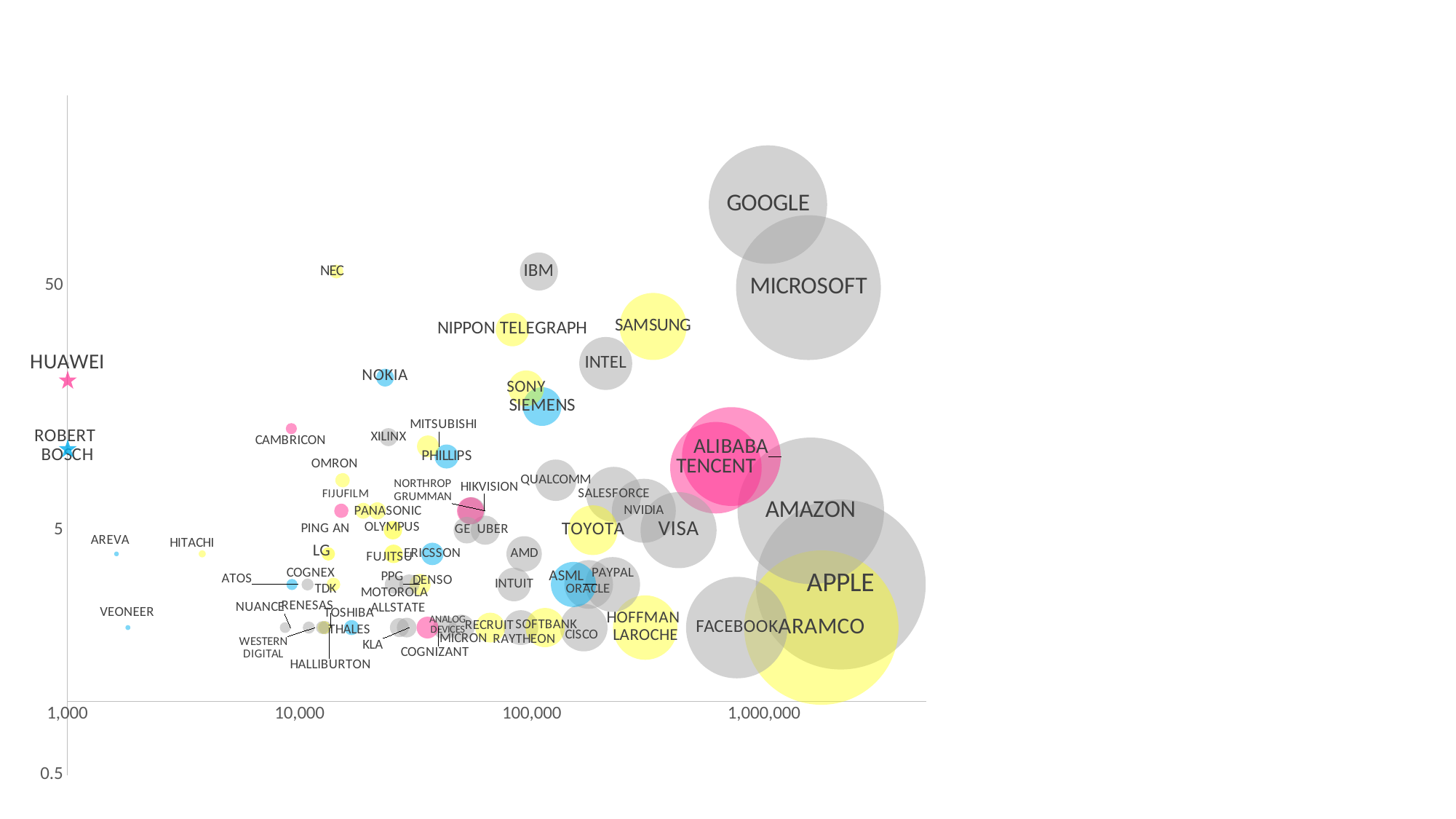
Is the vertical-axis value for SAMSUNG greater or less than 50? less Which two companies are marked with star symbols instead of bubbles? HUAWEI and ROBERT BOSCH Which is positioned higher on the vertical axis, GOOGLE or MICROSOFT? GOOGLE Is the horizontal-axis value for AREVA greater or less than 10,000? less Is the horizontal-axis value for SAMSUNG greater or less than 100,000? greater Which is positioned higher on the vertical axis, AMAZON or APPLE? AMAZON Which company's bubble is positioned highest on the vertical axis? GOOGLE What kind of chart is shown on the slide? bubble chart